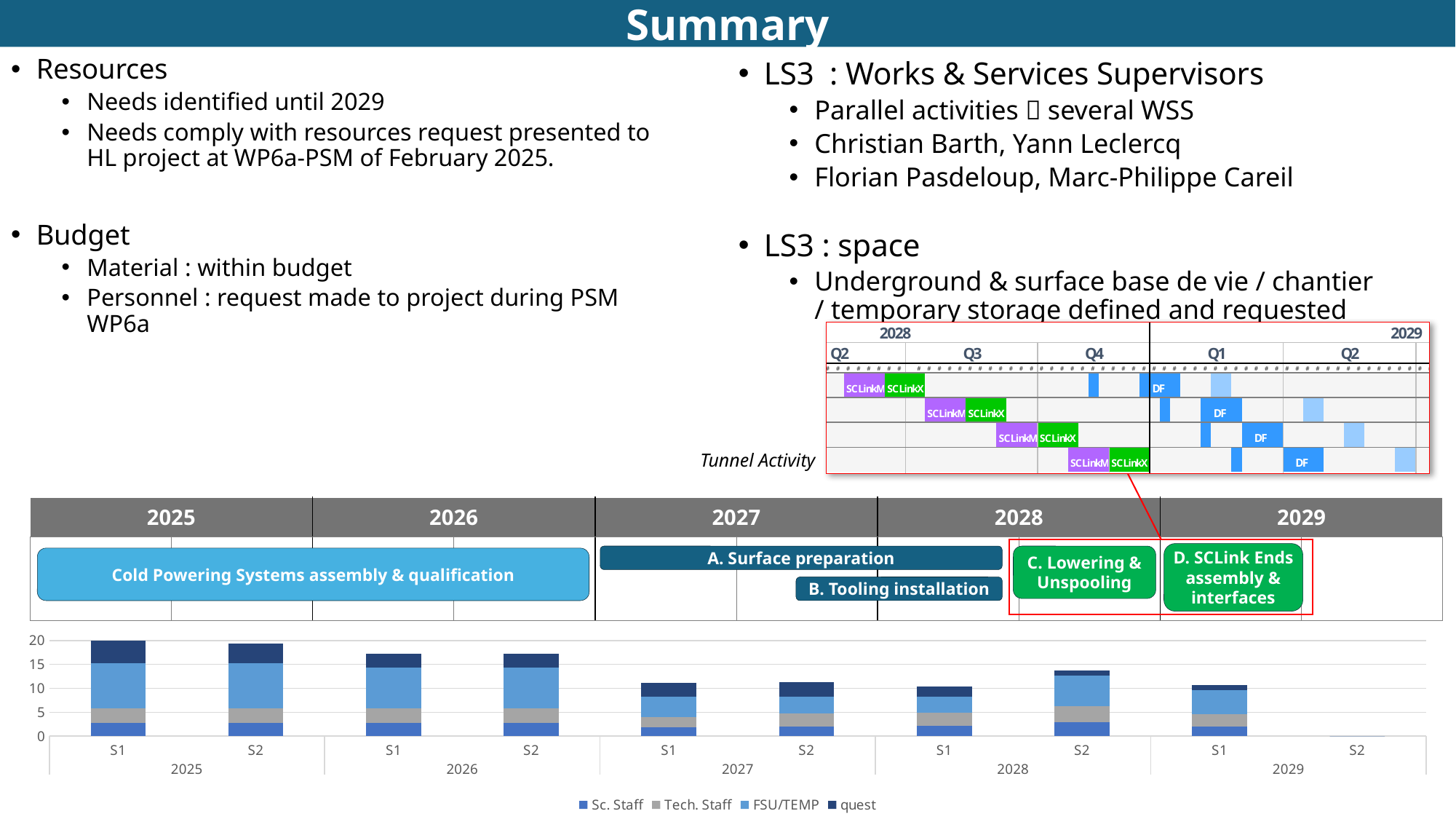
In the bar chart at the bottom, is the total for S1 2027 greater or less than 15? less How many series does the legend of the bar chart at the bottom list? 4 What kind of chart is shown at the bottom of the slide? stacked bar chart In the bar chart at the bottom, do the stacked totals generally rise or fall from 2025 to 2029? fall In the bar chart at the bottom, which series forms the bottom segment of each stacked bar? Sc. Staff In the bar chart at the bottom, is the total for S1 2025 greater or less than 15? greater In the bar chart at the bottom, which has the larger total: S1 2025 or S1 2027? S1 2025 What are the four series listed in the legend of the bar chart at the bottom? Sc. Staff, Tech. Staff, FSU/TEMP, quest In the bar chart at the bottom, which has the larger total: S2 2026 or S2 2027? S2 2026 In the bar chart at the bottom, is the total for S2 2028 greater or less than 10? greater How many categories (semesters) are shown on the x axis of the bar chart at the bottom? 10